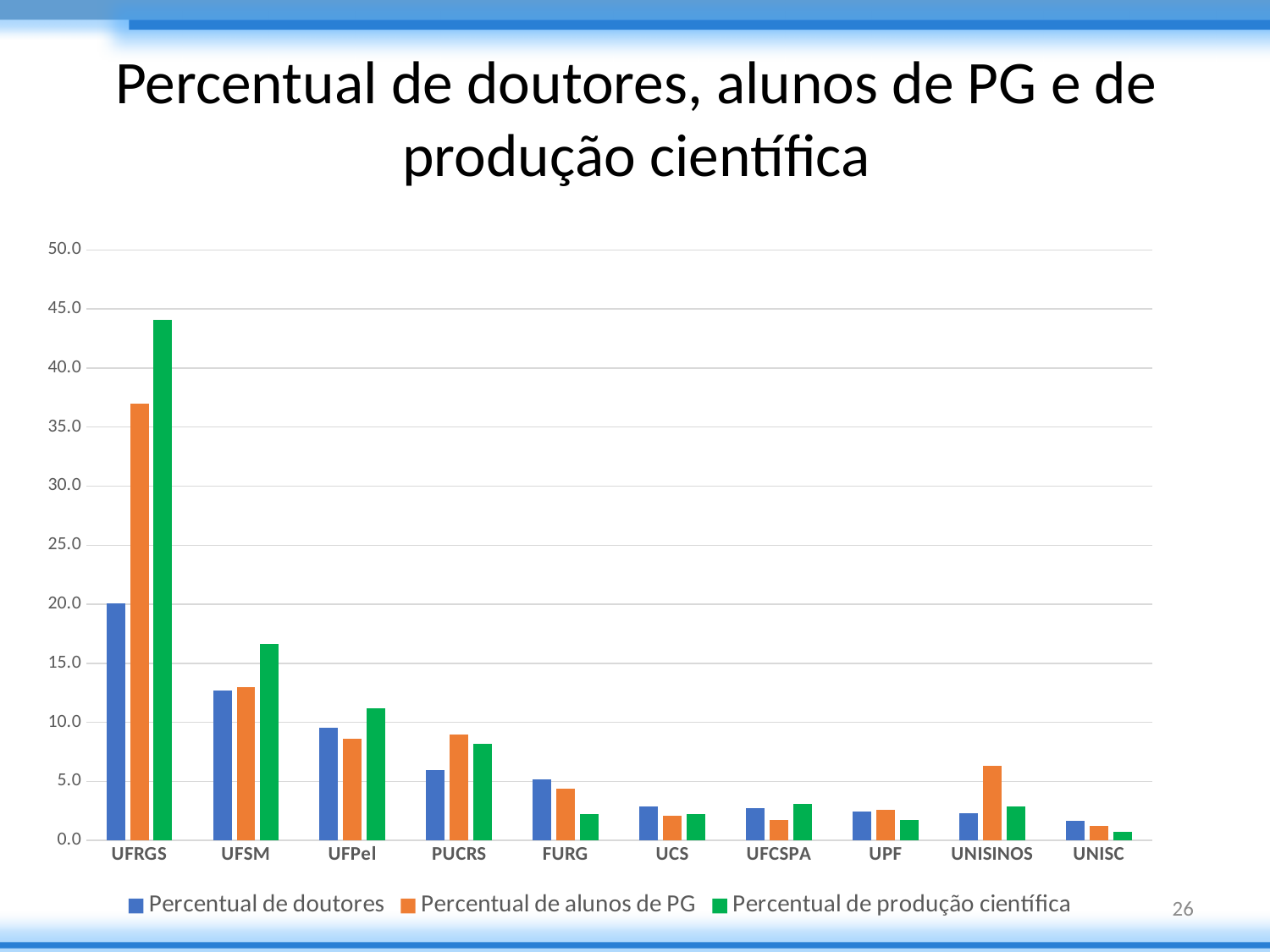
Is the value of Percentual de produção científica for UFRGS greater or less than 40.0? greater Which institution has the highest value for Percentual de produção científica? UFRGS Which institution has the highest value for Percentual de alunos de PG? UFRGS What kind of chart is shown on the slide? bar chart What is the title of the chart on the slide? Percentual de doutores, alunos de PG e de produção científica Which institution has the lowest value for Percentual de produção científica? UNISC Is the value of Percentual de produção científica for UFSM greater or less than 15.0? greater For UNISINOS, which is larger: Percentual de alunos de PG or Percentual de produção científica? Percentual de alunos de PG Is the value of Percentual de alunos de PG for UFRGS greater or less than 35.0? greater For PUCRS, which is larger: Percentual de doutores or Percentual de alunos de PG? Percentual de alunos de PG How many institutions are shown on the x axis of the chart? 10 How many series does the legend list? 3